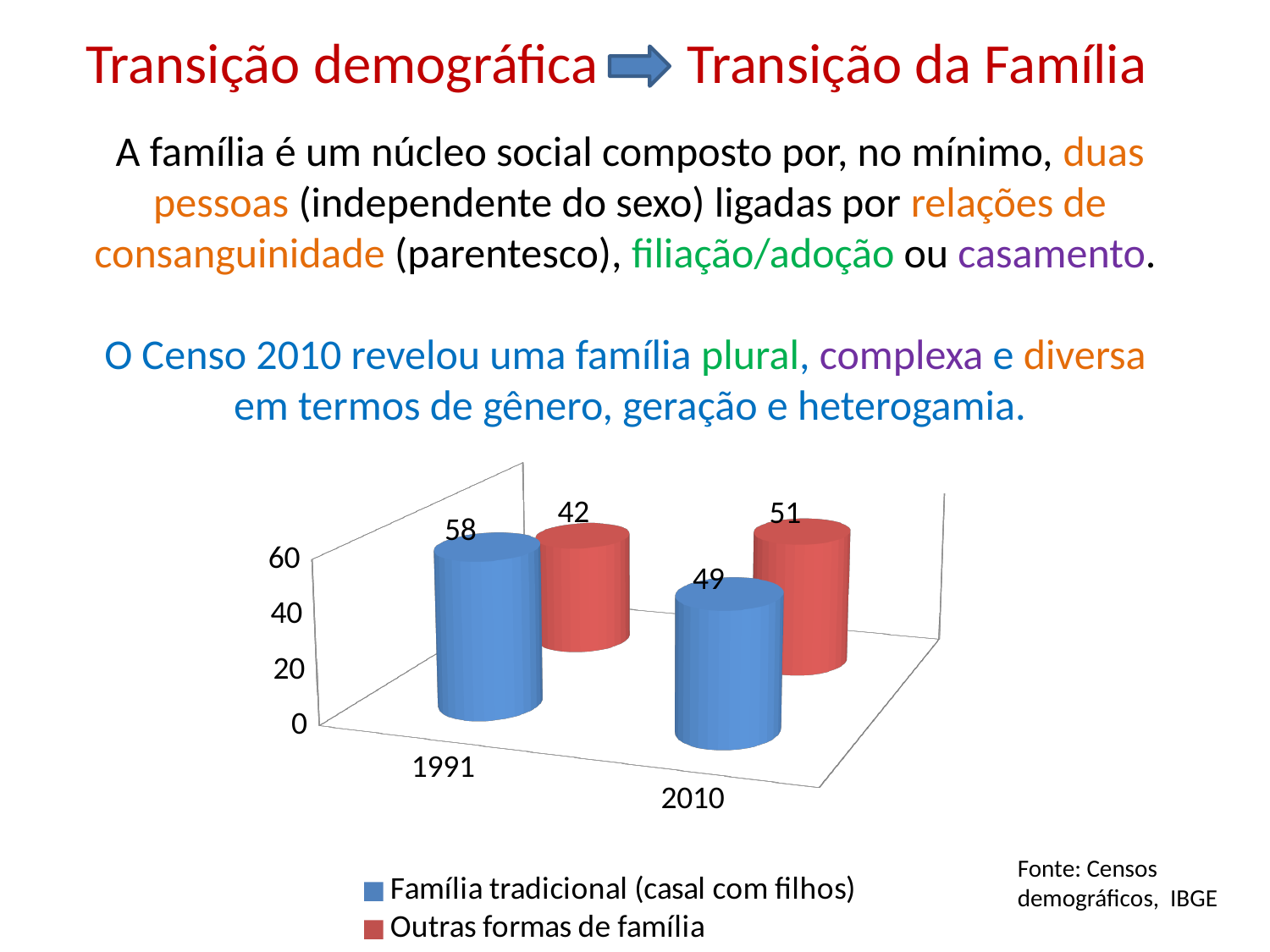
What is the difference between Família tradicional (casal com filhos) in 1991 and in 2010? 9 How many series does the legend list? 2 What is the value for Família tradicional (casal com filhos) in 2010? 49 What is the value for Outras formas de família in 2010? 51 In which year is the value for Outras formas de família lowest? 1991 What is the value for Outras formas de família in 1991? 42 Does the value for Família tradicional (casal com filhos) rise or fall from 1991 to 2010? fall In which year is the value for Família tradicional (casal com filhos) highest? 1991 What is the value for Família tradicional (casal com filhos) in 1991? 58 What kind of chart is shown on the slide? bar chart Which is larger in 2010: Família tradicional (casal com filhos) or Outras formas de família? Outras formas de família How many years are shown on the x axis of the chart? 2